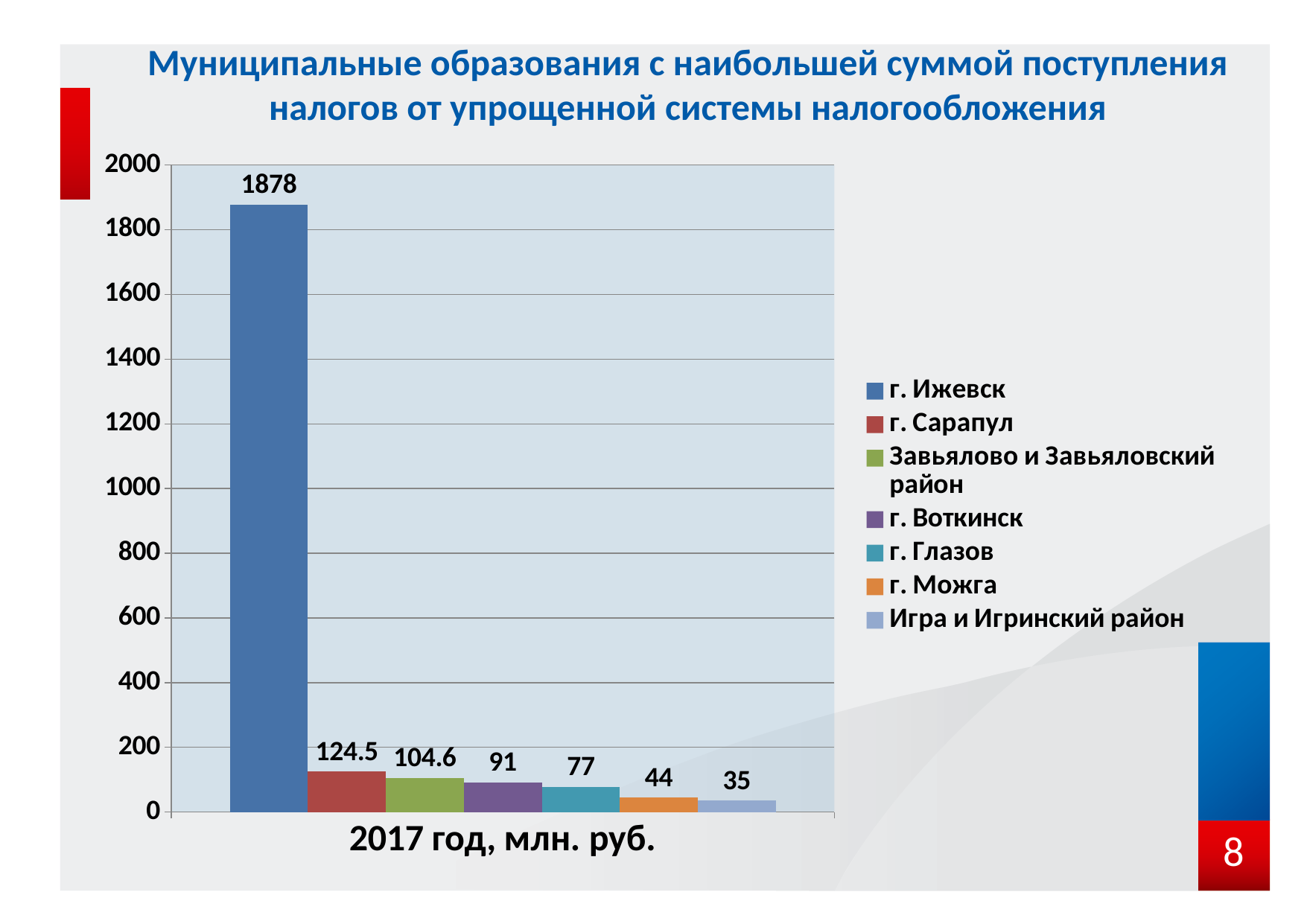
Is the value for г. Ижевск greater or less than 1800? greater What is the value for г. Ижевск? 1878 How many series does the legend list? 7 What is the value for г. Глазов? 77 Which is larger, the value for г. Сарапул or the value for г. Воткинск? г. Сарапул Which municipality has the highest value? г. Ижевск What is the difference between the values for г. Воткинск and г. Можга? 47 What is the value for Завьялово и Завьяловский район? 104.6 What is the label on the x axis below the bars? 2017 год, млн. руб. Which municipality has the lowest value? Игра и Игринский район What is the value for г. Сарапул? 124.5 What kind of chart is shown on the slide? bar chart